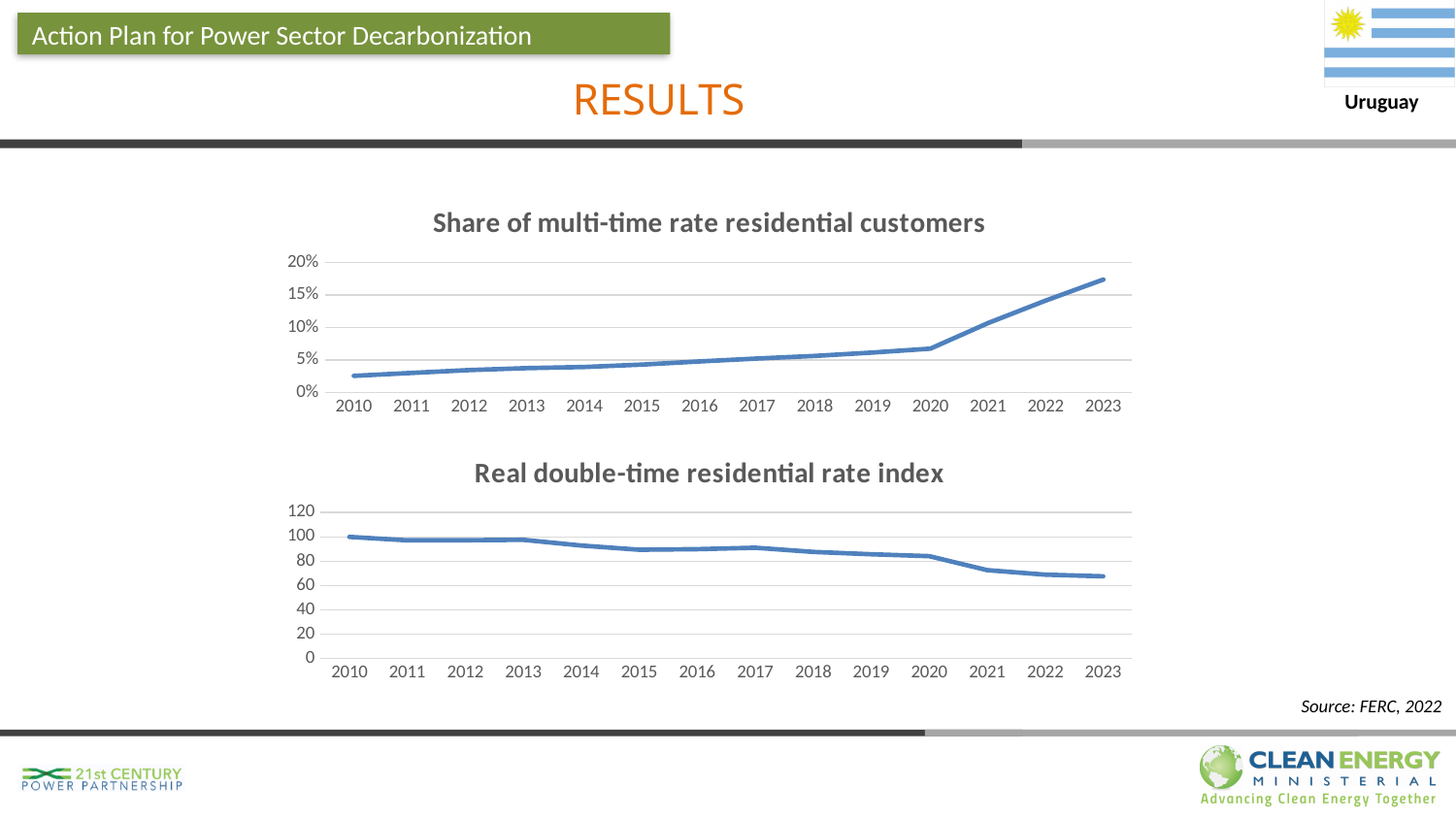
In the 'Share of multi-time rate residential customers' chart, do the values rise or fall from 2010 to 2023? rise In the 'Share of multi-time rate residential customers' chart, is the value for 2010 greater or less than 5%? less In the 'Share of multi-time rate residential customers' chart, which year has the highest value? 2023 How many years are plotted on the x axis of the 'Share of multi-time rate residential customers' chart? 14 In the 'Share of multi-time rate residential customers' chart, is the value for 2023 greater or less than 15%? greater In the 'Real double-time residential rate index' chart, is the value for 2017 greater or less than 80? greater What type of chart is the 'Share of multi-time rate residential customers' chart? line chart In the 'Real double-time residential rate index' chart, which is larger, the value for 2010 or the value for 2023? 2010 In the 'Real double-time residential rate index' chart, do the values rise or fall from 2010 to 2023? fall In the 'Real double-time residential rate index' chart, which year has the highest value? 2010 In the 'Share of multi-time rate residential customers' chart, which year has the lowest value? 2010